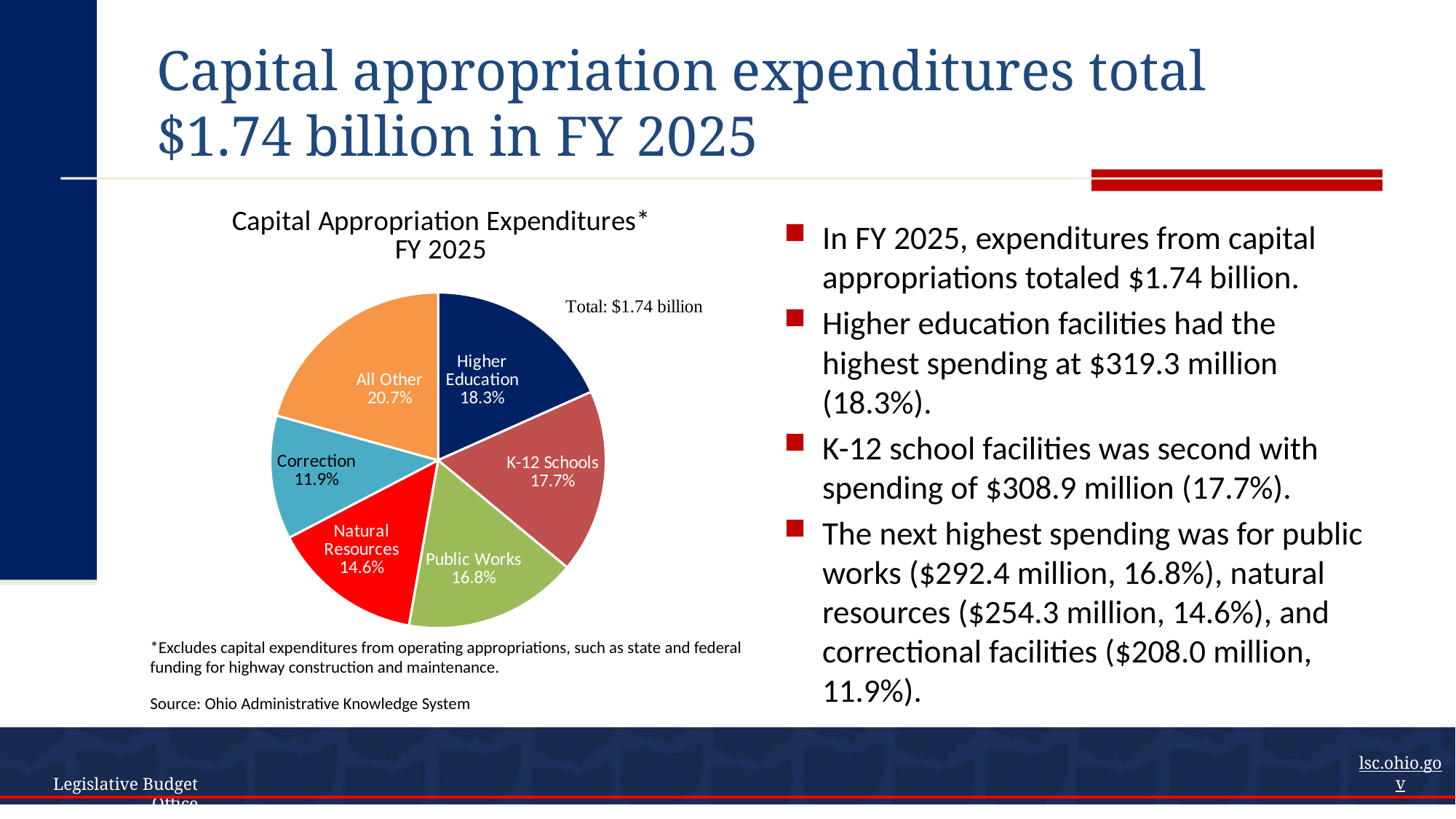
What share of the pie does Correction represent? 11.9% What share of the pie does Natural Resources represent? 14.6% Which slice is larger, Public Works or Natural Resources? Public Works How many slices does the pie chart have? 6 What total is printed next to the pie chart? Total: $1.74 billion What share of the pie does K-12 Schools represent? 17.7% Which slice of the pie is the largest? All Other What is the difference in percentage points between the Natural Resources and Correction slices? 2.7 What kind of chart is shown on the slide? pie chart Which slice of the pie is the smallest? Correction